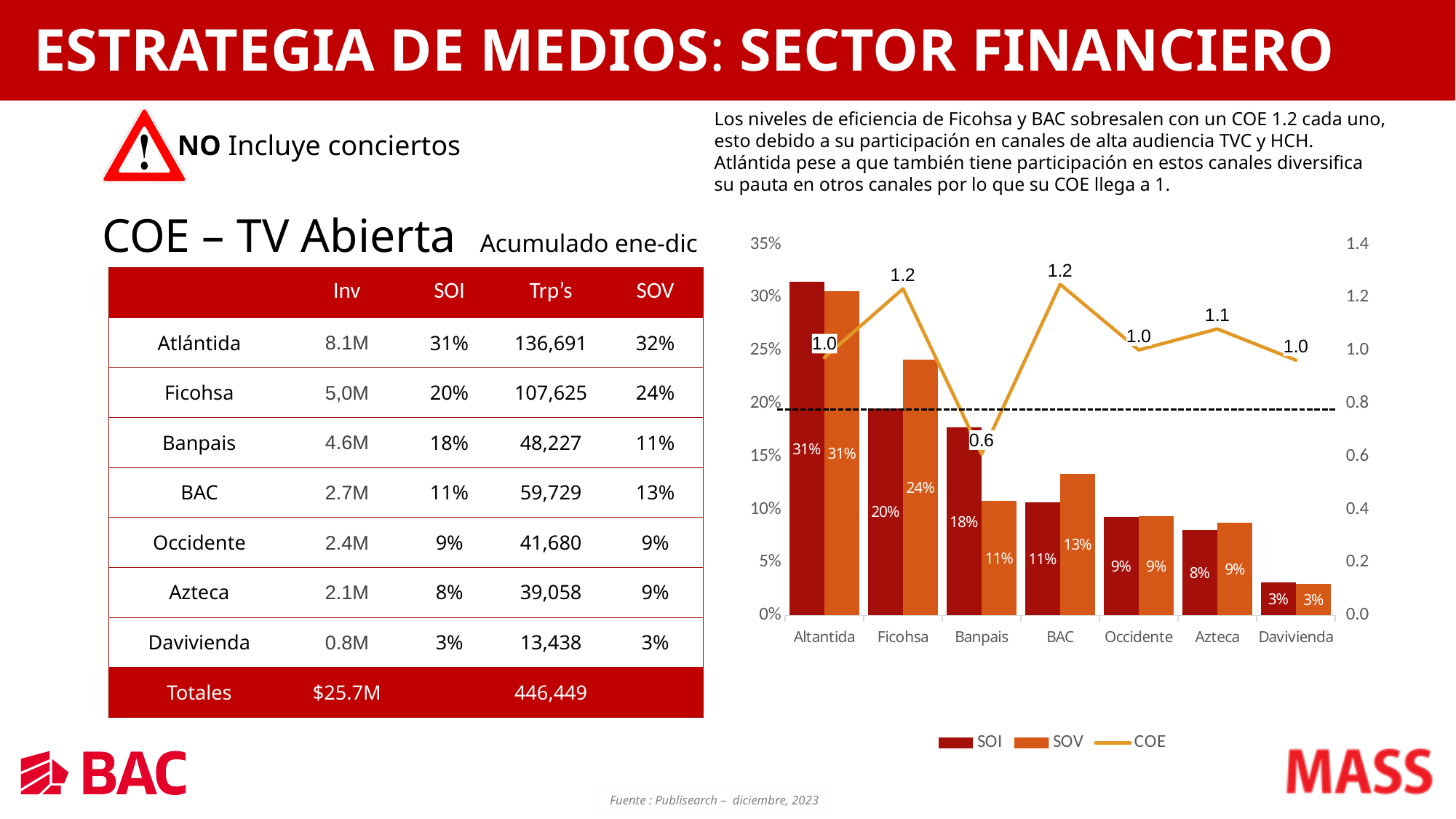
What is the SOI value for Banpais in the chart? 18% What is the difference between the SOV and SOI values for Ficohsa in the chart? 4% Which series in the chart is drawn as a line? COE How many categories are shown on the x axis of the chart? 7 Does the SOI value generally rise or fall moving from Altantida to Davivienda along the x axis? Fall What is the COE value for Banpais in the chart? 0.6 What is the SOV value for Ficohsa in the chart? 24% Which category has the highest SOI value in the chart? Altantida Which is larger for BAC in the chart, SOI or SOV? SOV How many series does the chart legend list? 3 What type of chart is shown on the slide? Combination bar and line chart Which category has the lowest COE value in the chart? Banpais